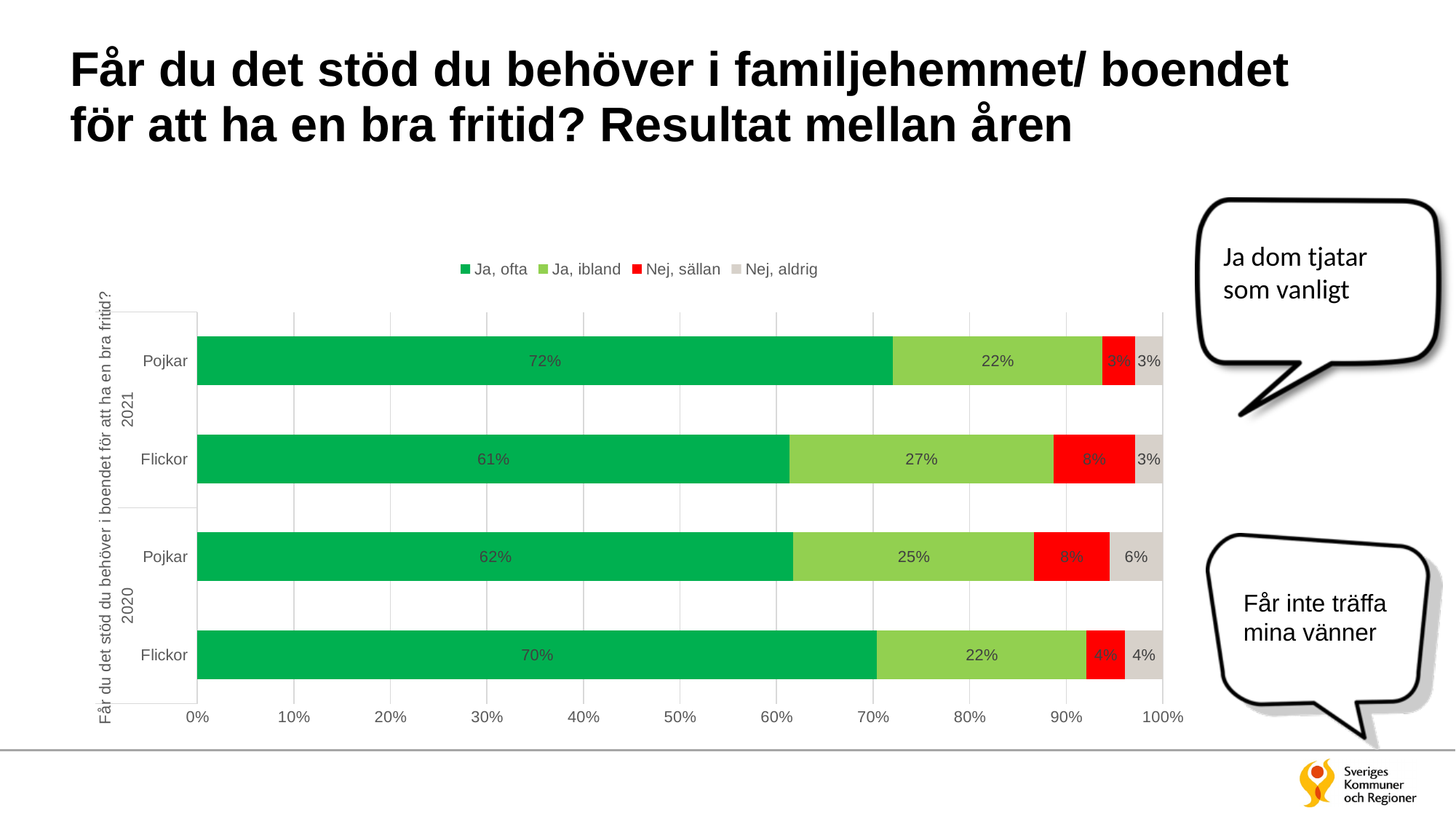
What is the "Ja, ibland" value for Flickor in 2021? 27% What is the "Nej, aldrig" value for Pojkar in 2020? 6% What is the "Ja, ofta" value for Pojkar in 2021? 72% How many bars are plotted in the chart? 4 What kind of chart is shown on the slide? Stacked bar chart Which bar has the highest "Ja, ofta" value? Pojkar 2021 How many series does the legend list? 4 What is the "Nej, sällan" value for Flickor in 2020? 4% What is the difference between the "Ja, ofta" values for Pojkar in 2021 and Pojkar in 2020? 10 percentage points Which bar has the lowest "Ja, ofta" value? Flickor 2021 Which is larger: the "Nej, sällan" value for Flickor in 2021 or for Flickor in 2020? Flickor 2021 What is the last entry in the legend? Nej, aldrig